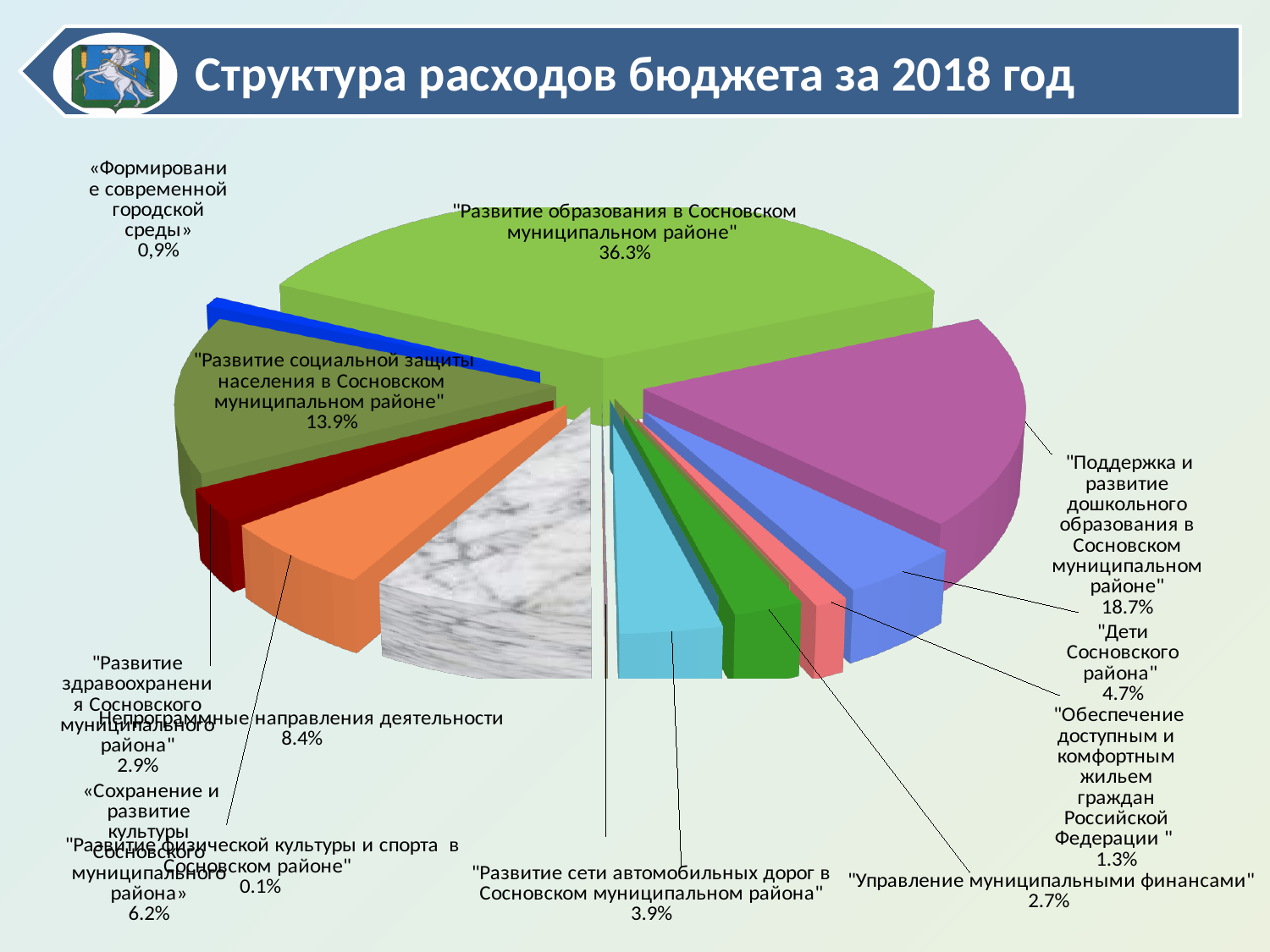
What share of the budget expenditure goes to "Развитие образования в Сосновском муниципальном районе"? 36.3% What percentage is shown for "Развитие социальной защиты населения в Сосновском муниципальном районе"? 13.9% Which category has the largest share of the pie? "Развитие образования в Сосновском муниципальном районе" What share is labelled for "Непрограммные направления деятельности"? 8.4% What percentage is shown for "Поддержка и развитие дошкольного образования в Сосновском муниципальном районе"? 18.7% What percentage is shown for "Управление муниципальными финансами"? 2.7% What is the difference in percentage points between "Развитие образования в Сосновском муниципальном районе" (36.3%) and "Поддержка и развитие дошкольного образования в Сосновском муниципальном районе" (18.7%)? 17.6 What type of chart is shown on the slide? pie chart What is the title of the chart on the slide? Структура расходов бюджета за 2018 год Which is larger: the share for "Дети Сосновского района" or the share for "Развитие сети автомобильных дорог в Сосновском муниципальном района"? "Дети Сосновского района"